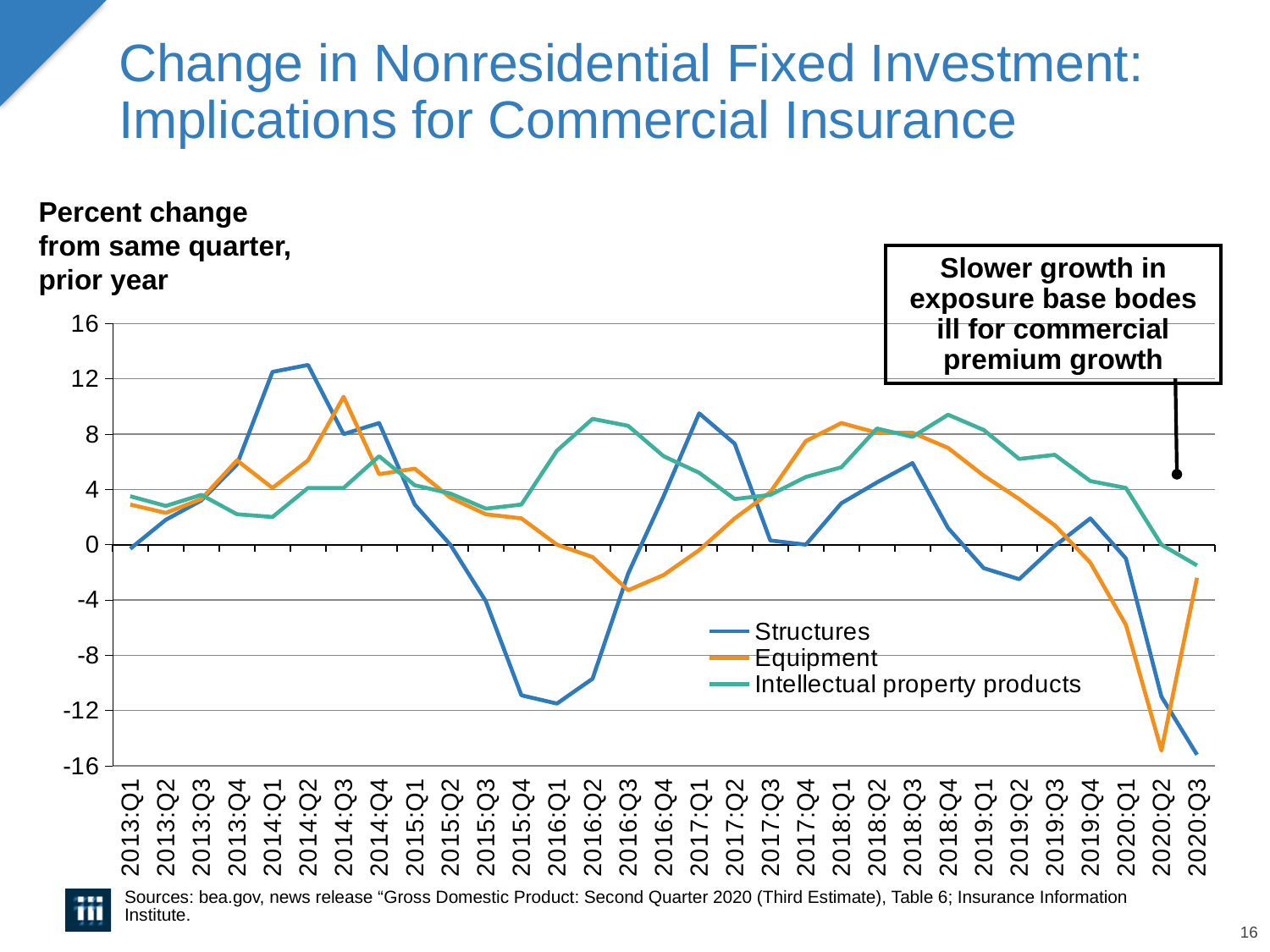
Which series is plotted in orange? Equipment Is the value for Structures in 2016:Q1 greater or less than -8? less What does the y axis measure, according to the label above the chart? Percent change from same quarter, prior year Does the Structures line rise or fall from 2014:Q2 to 2016:Q1? fall In 2016:Q1, which series has the larger value, Structures or Intellectual property products? Intellectual property products Is the value for Structures in 2014:Q2 greater or less than 12? greater In 2020:Q2, which series has the larger value, Structures or Equipment? Structures Is the value for Equipment in 2020:Q2 greater or less than -12? less What kind of chart is shown on the slide? line chart How many series does the legend list? 3 How many quarters are shown along the x axis? 31